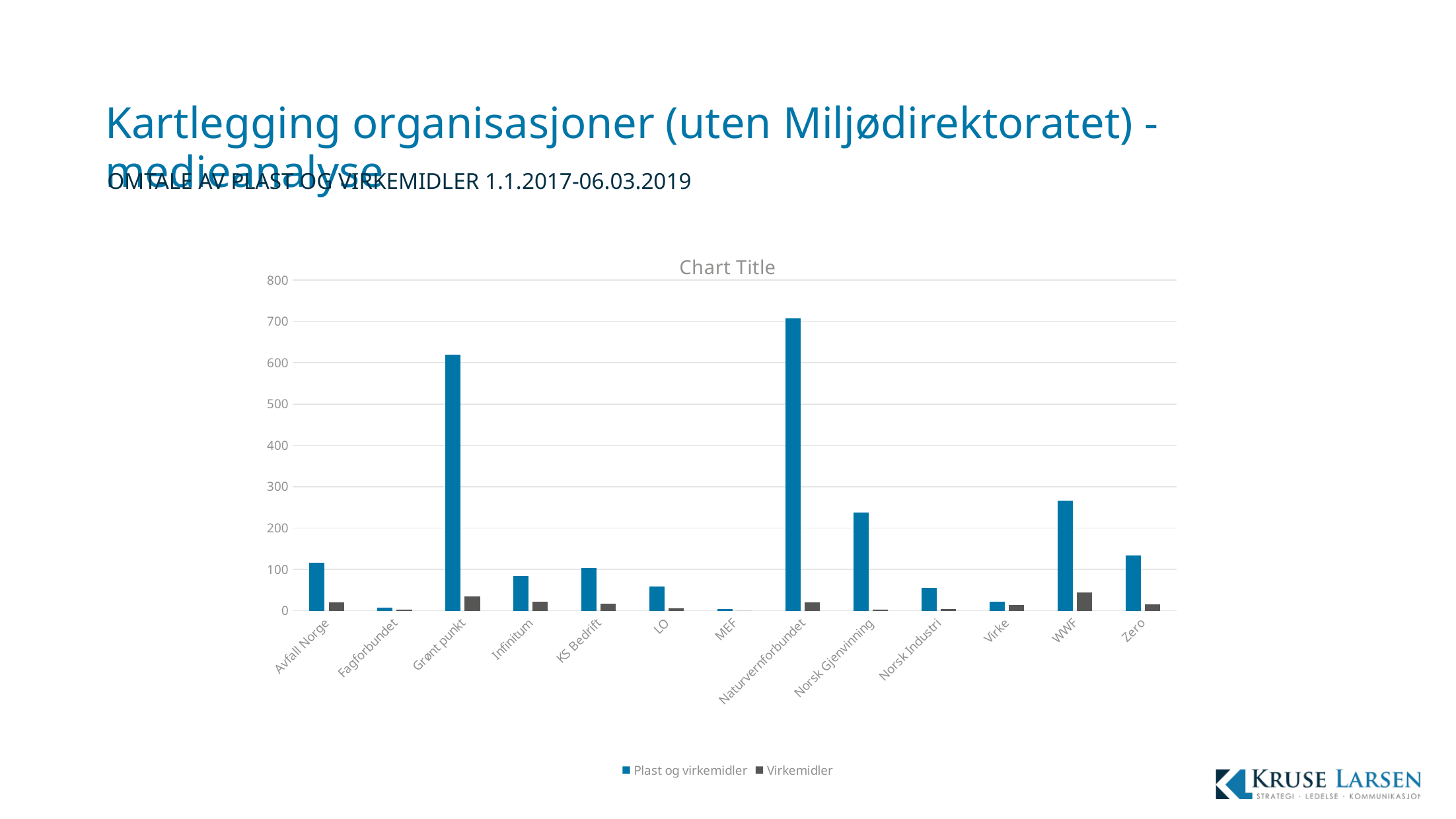
What kind of chart is shown on the slide? bar chart How many organisations (categories) are shown on the x axis? 13 Is the Plast og virkemidler value for Naturvernforbundet greater or less than 600? greater Which has the larger Plast og virkemidler value, Norsk Gjenvinning or Zero? Norsk Gjenvinning How many series does the legend list? 2 What are the two series named in the legend? Plast og virkemidler and Virkemidler Is the Plast og virkemidler value for Norsk Gjenvinning greater or less than 200? greater Is the Plast og virkemidler value for Grønt punkt greater or less than 500? greater Which organisation has the highest value for Plast og virkemidler? Naturvernforbundet Which has the larger Plast og virkemidler value, Grønt punkt or WWF? Grønt punkt